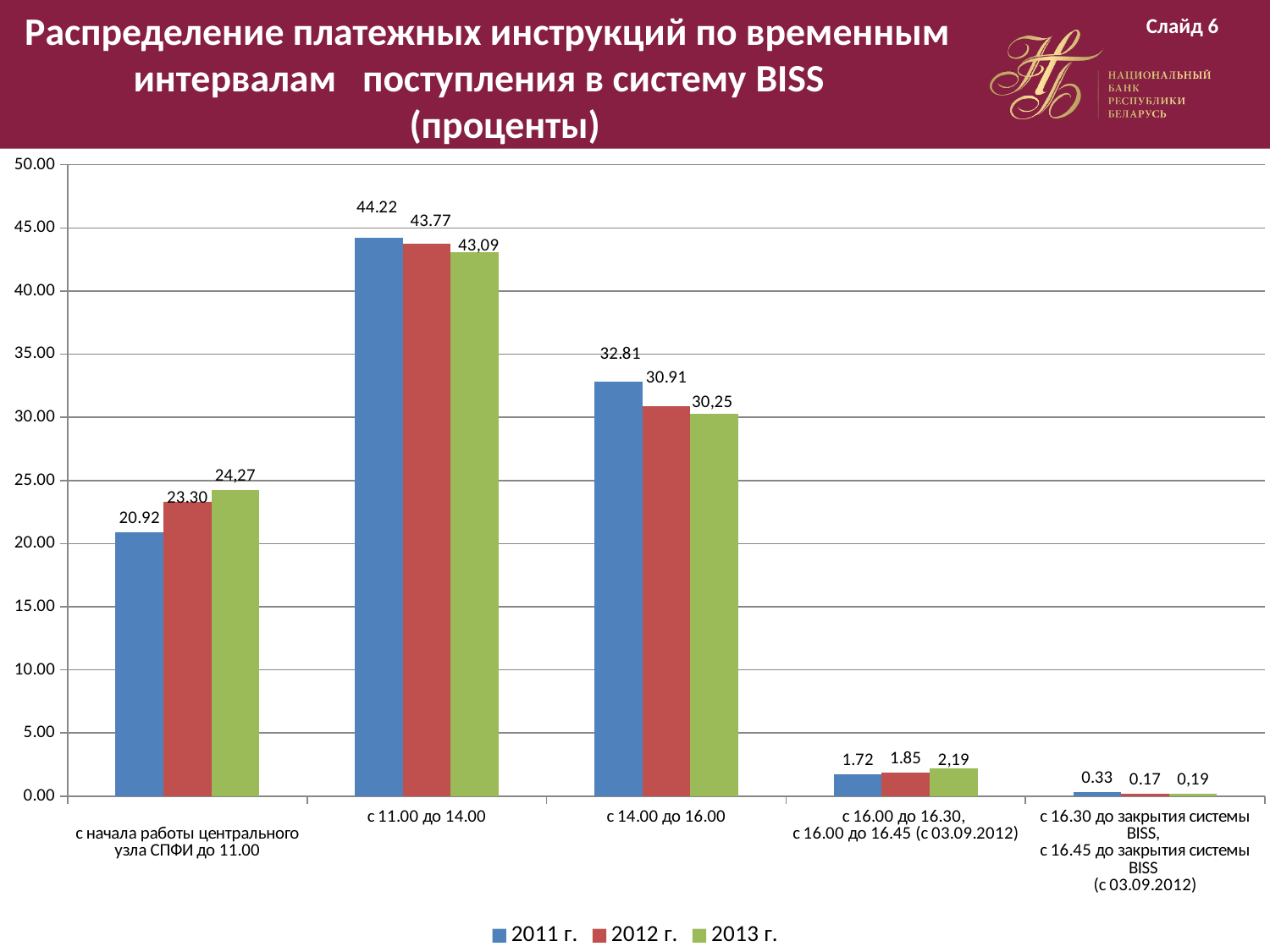
How many time-interval categories are shown on the x axis? 5 Which category has the highest value for 2011 г.? с 11.00 до 14.00 What is the value for 2011 г. in the category «с 11.00 до 14.00»? 44.22 How many series does the legend list? 3 What is the value for 2013 г. in the category «с 16.00 до 16.30, с 16.00 до 16.45 (с 03.09.2012)»? 2,19 What is the difference between the 2011 г. and 2012 г. values in the category «с 14.00 до 16.00»? 1.90 What type of chart is shown on the slide? bar chart Which colour represents the 2012 г. series in the legend? red What is the value for 2013 г. in the category «с начала работы центрального узла СПФИ до 11.00»? 24,27 Which category has the lowest value for 2012 г.? с 16.30 до закрытия системы BISS, с 16.45 до закрытия системы BISS (с 03.09.2012) In the category «с начала работы центрального узла СПФИ до 11.00», which is larger: the value for 2011 г. or for 2013 г.? 2013 г. What is the value for 2012 г. in the category «с 14.00 до 16.00»? 30.91